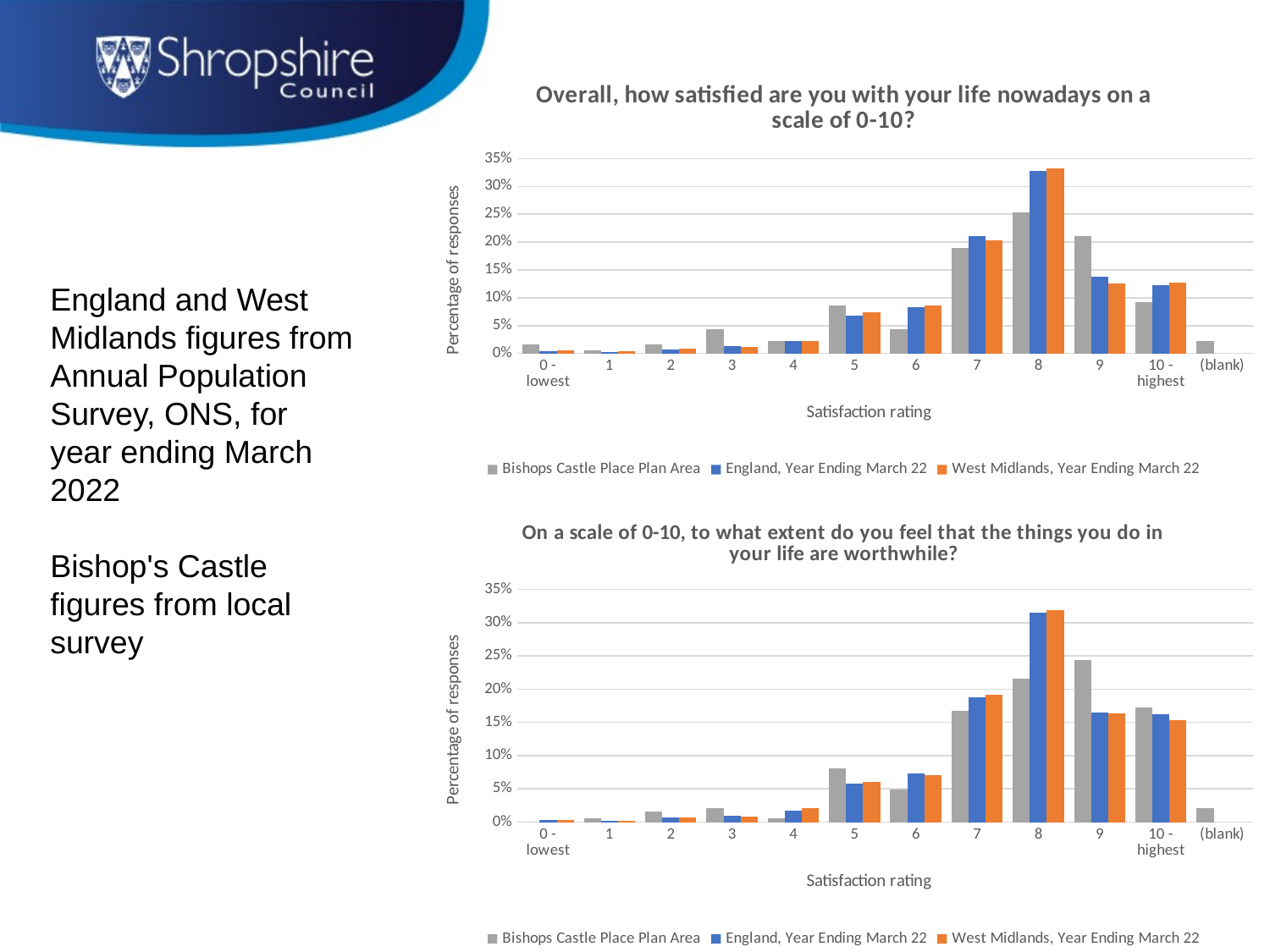
In the bottom chart, which rating has the highest percentage for England, Year Ending March 22? 8 In the bottom chart, is the value for West Midlands, Year Ending March 22 at rating 8 greater or less than 30%? greater In the top chart, which satisfaction rating has the highest percentage of responses for Bishops Castle Place Plan Area? 8 In the top chart, at rating 9, which is larger: Bishops Castle Place Plan Area or England, Year Ending March 22? Bishops Castle Place Plan Area In the bottom chart, 'On a scale of 0-10, to what extent do you feel that the things you do in your life are worthwhile?', which rating has the highest percentage for Bishops Castle Place Plan Area? 9 What is the y-axis title of the bottom chart? Percentage of responses In the top chart, how many series does the legend list? 3 In the bottom chart, at rating 8, which is larger: Bishops Castle Place Plan Area or England, Year Ending March 22? England, Year Ending March 22 In the top chart, is the value for England, Year Ending March 22 at rating 8 greater or less than 30%? greater What kind of chart is the top chart, 'Overall, how satisfied are you with your life nowadays on a scale of 0-10?'? Bar chart In the top chart, is the value for Bishops Castle Place Plan Area at rating 8 greater or less than 30%? less In the top chart, how many satisfaction rating categories are shown on the x axis? 12